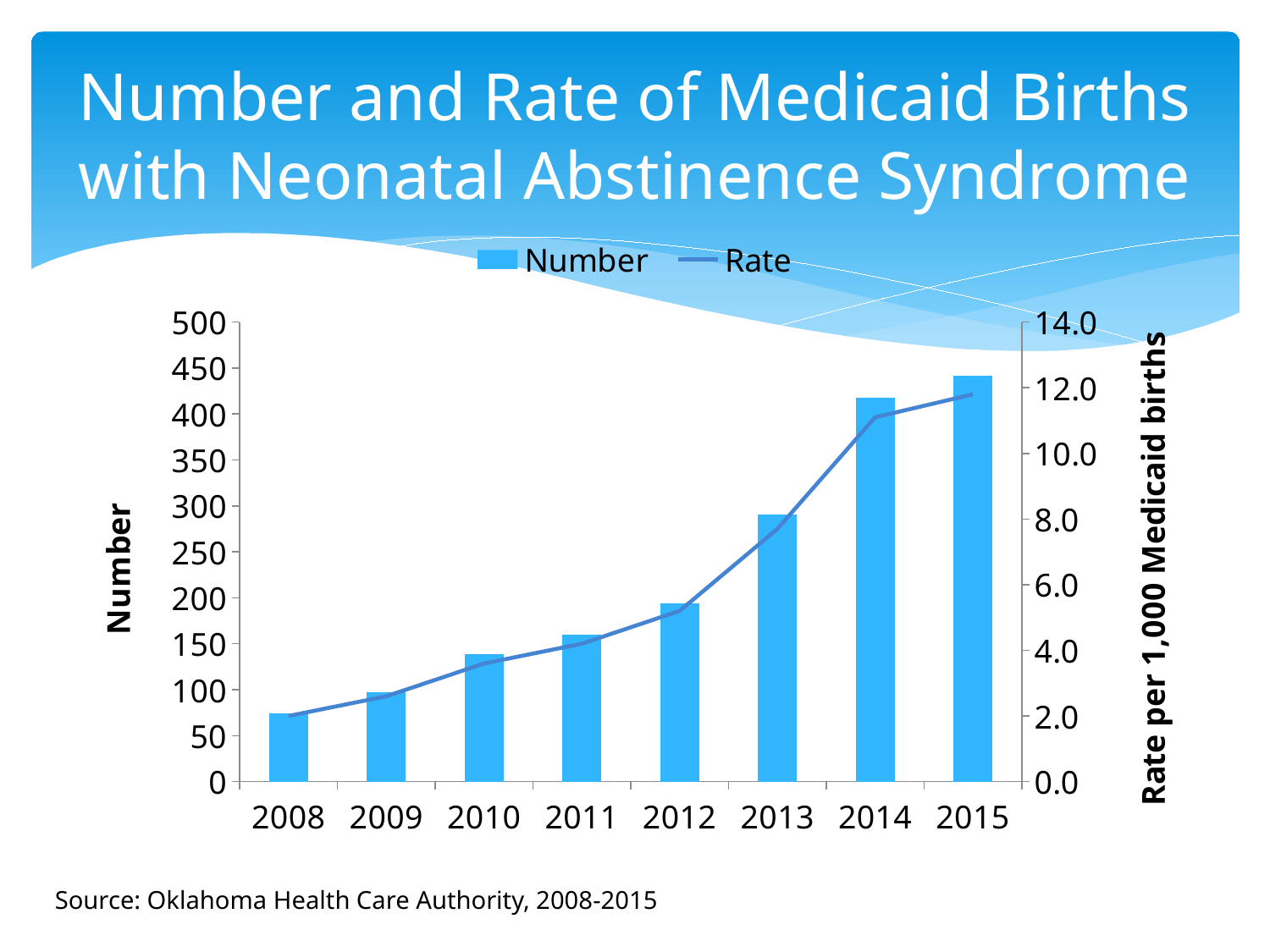
Do the Number values rise or fall from 2008 to 2015? rise How many series does the legend list? 2 What kind of chart is shown on the slide? A combined bar and line chart Is the Rate for 2015 greater or less than 10.0 per 1,000 Medicaid births? greater Which year has the lowest Number of Medicaid births with Neonatal Abstinence Syndrome? 2008 How many years are shown along the x axis? 8 Is the Rate for 2008 greater or less than 4.0 per 1,000 Medicaid births? less Which year has the larger Number, 2012 or 2013? 2013 What is the title of the right-hand vertical axis? Rate per 1,000 Medicaid births Is the Number bar for 2014 greater or less than 400? greater Which year has the highest Number of Medicaid births with Neonatal Abstinence Syndrome? 2015